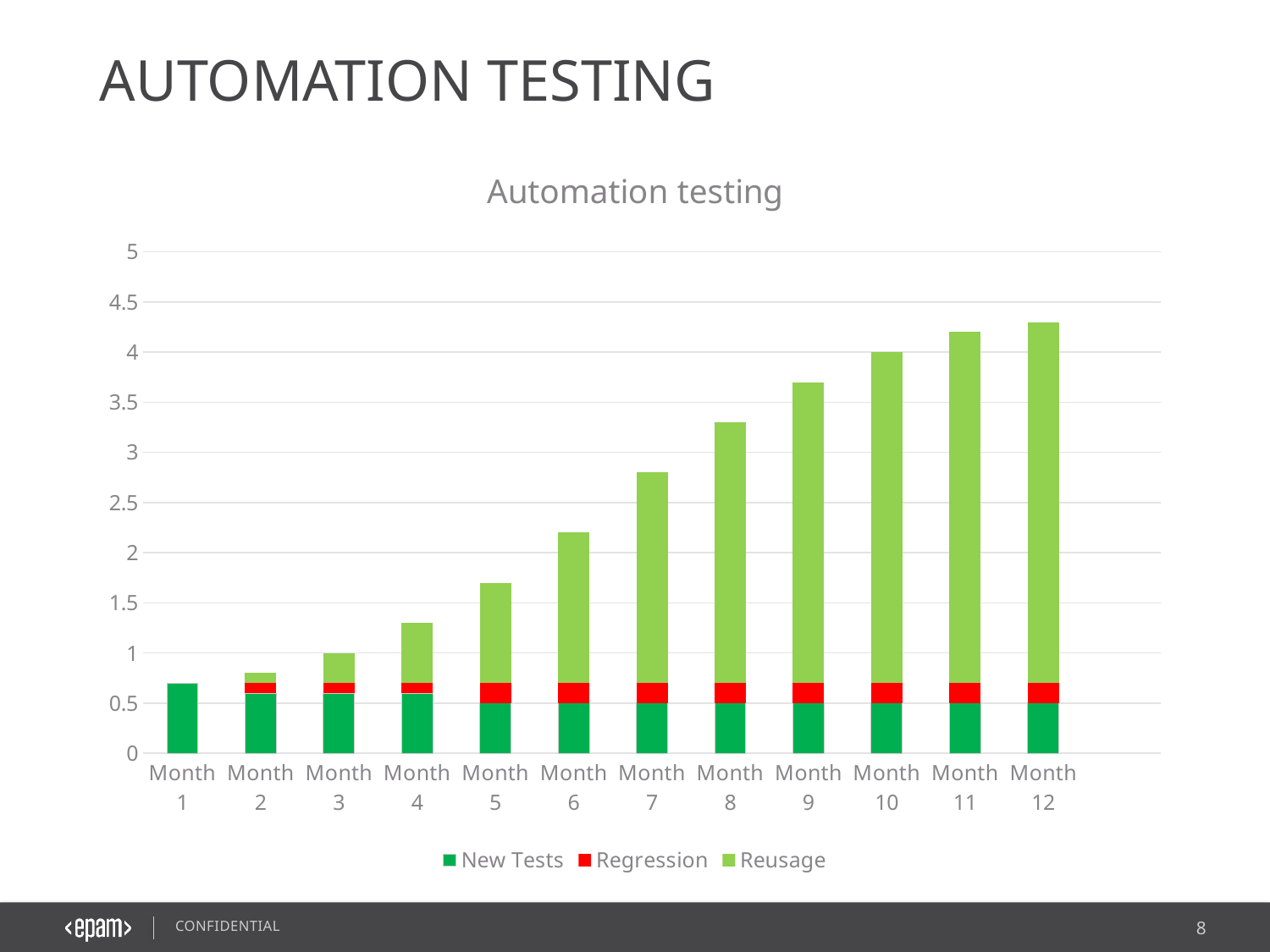
What is the title of the chart? Automation testing How many series does the legend list? 3 Is the total bar height for Month 1 greater or less than 1? less Is the total bar height for Month 6 greater or less than 2? greater Do the total bar heights rise or fall from Month 1 to Month 12? Rise Is the total bar height for Month 12 greater or less than 4? greater Which is taller, the stacked bar for Month 8 or the stacked bar for Month 5? Month 8 Which series is shown in red in the legend? Regression How many months are shown on the x axis? 12 Which month has the tallest stacked bar? Month 12 Which month has the shortest stacked bar? Month 1 What kind of chart is shown on the slide? Stacked bar chart